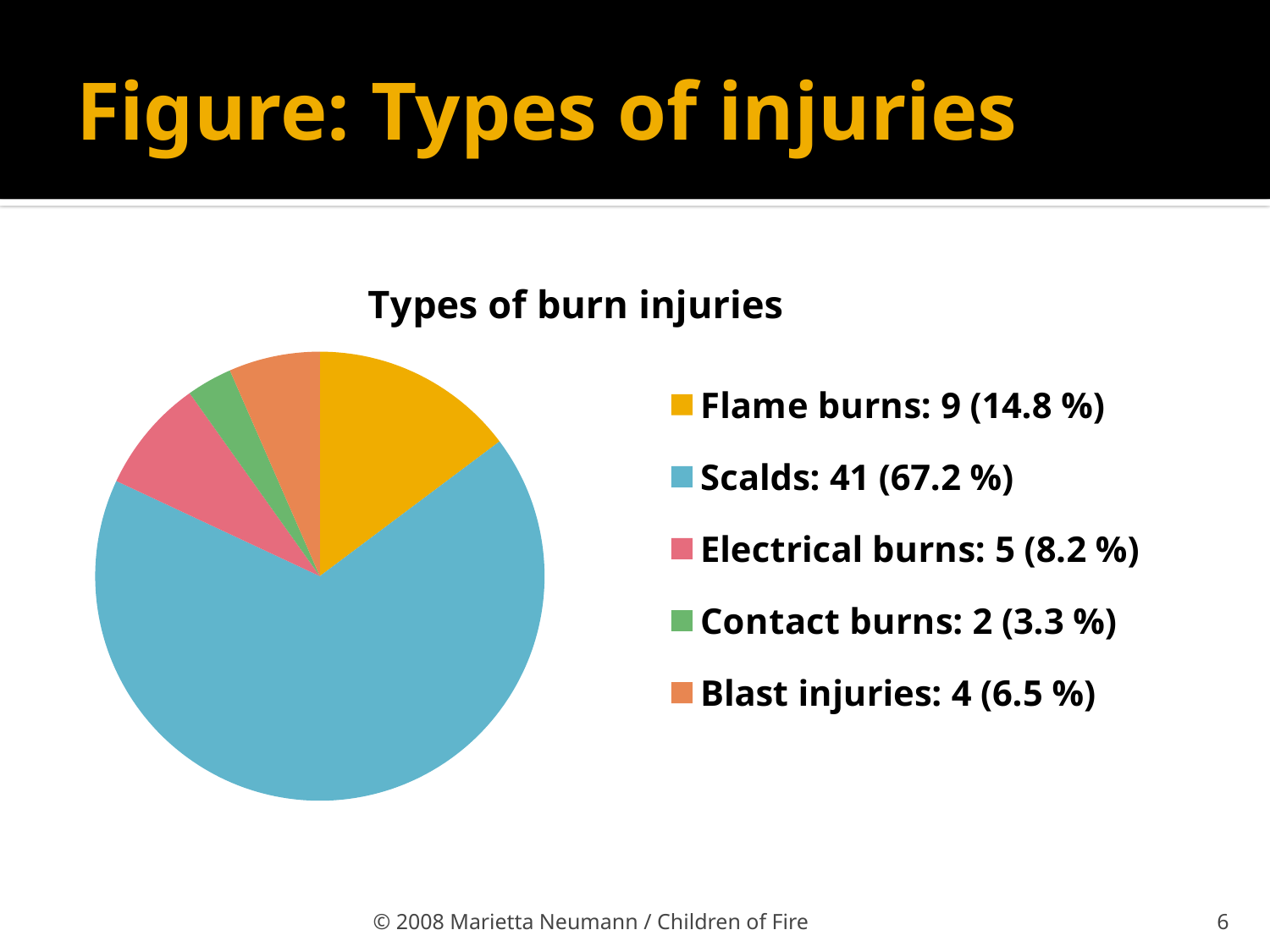
What kind of chart is shown on the slide? pie chart Which has more cases, electrical burns or blast injuries? Electrical burns What colour is the slice for blast injuries? orange Which type of injury has the smallest slice? Contact burns How many categories does the pie chart show? 5 What percentage share do electrical burns have? 8.2 % How many cases of scalds are shown in the legend? 41 What is the title of the chart? Types of burn injuries What percentage share do flame burns have? 14.8 % How many contact burns are shown in the legend? 2 Which type of injury has the largest slice? Scalds What is the difference in number of cases between scalds and flame burns? 32